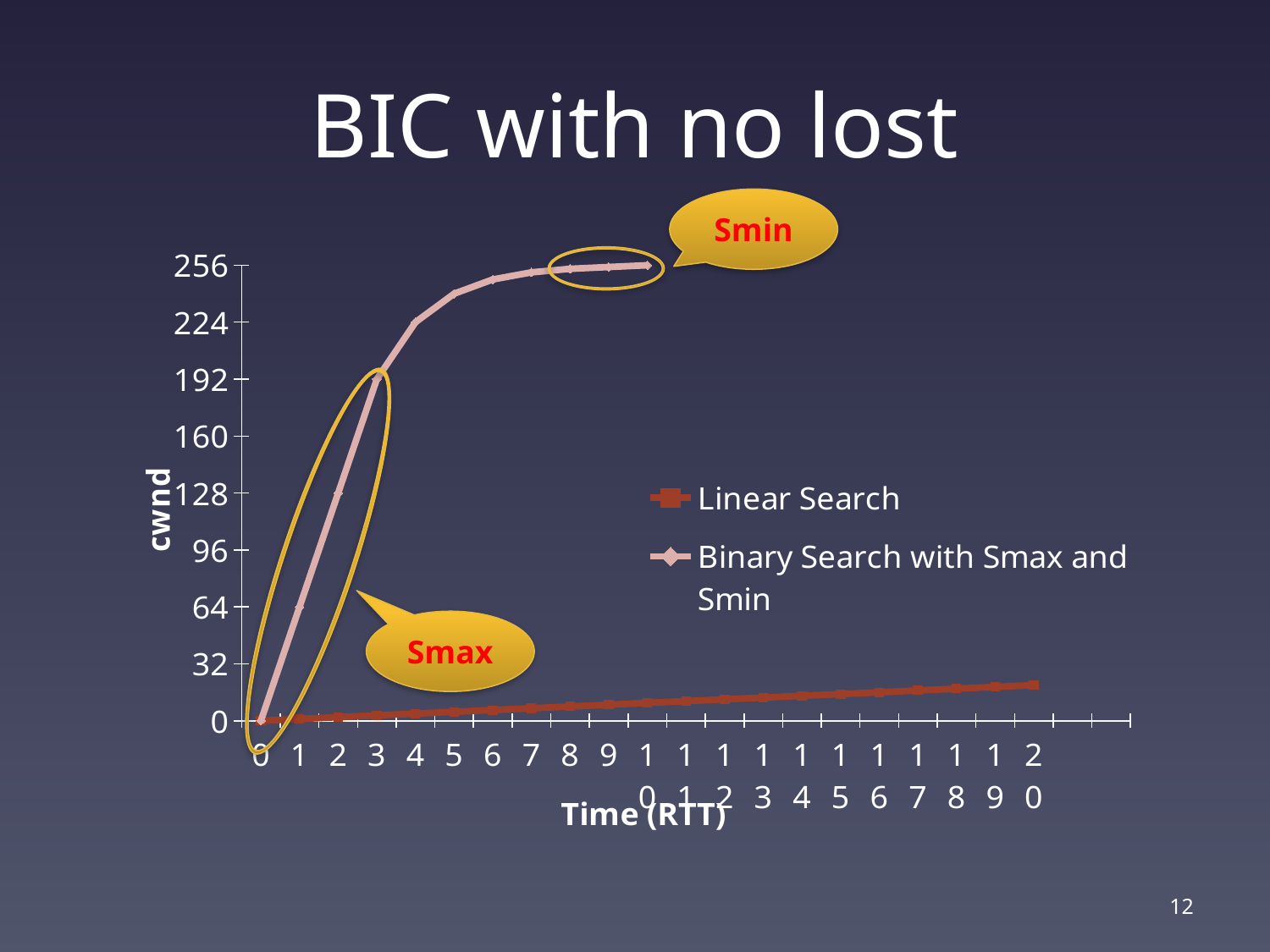
Is the cwnd value for Binary Search with Smax and Smin at time 5 RTT greater or less than 224? greater What is the cwnd value for Binary Search with Smax and Smin at time 1 RTT? 64 Does the cwnd value for Linear Search rise or fall as time increases? rise What is the label of the y axis? cwnd What is the cwnd value for Binary Search with Smax and Smin at time 10 RTT? 256 Is the cwnd value for Linear Search at time 20 RTT greater or less than 32? less What is the cwnd value for Binary Search with Smax and Smin at time 3 RTT? 192 What kind of chart is shown on the slide? line chart How many series does the legend list? 2 Which series reaches the higher cwnd value at time 10 RTT, Linear Search or Binary Search with Smax and Smin? Binary Search with Smax and Smin What is the cwnd value for Binary Search with Smax and Smin at time 2 RTT? 128 What is the title of the slide's chart? BIC with no lost